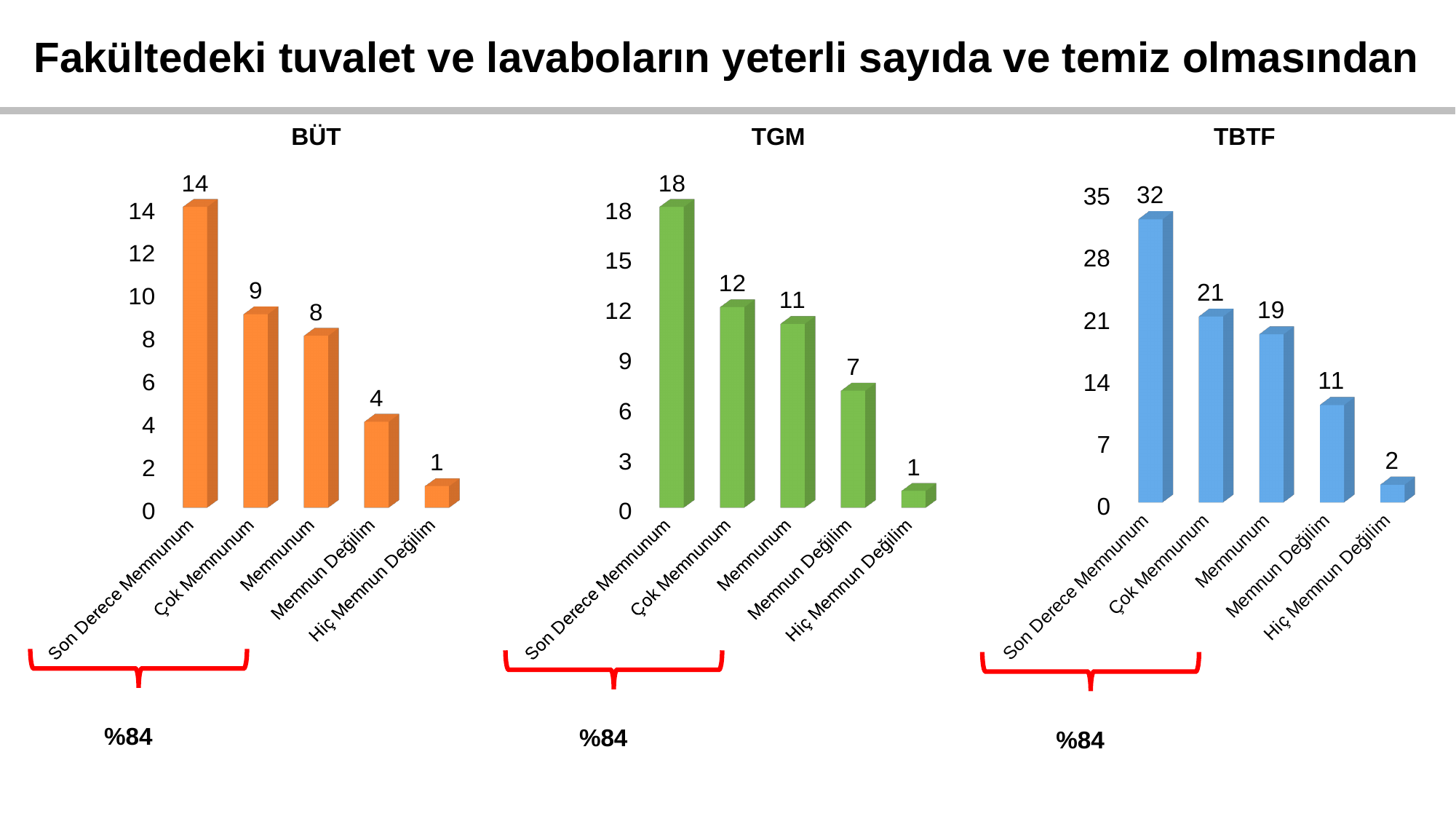
In the BÜT chart, what is the difference between Çok Memnunum and Memnunum? 1 What colour are the bars in the TBTF chart? blue What kind of chart is the TGM chart? bar chart In the TGM chart, which category has the lowest value? Hiç Memnun Değilim In the TBTF chart, what is the difference between Son Derece Memnunum and Memnunum? 13 In the TBTF chart, do the values rise or fall from left to right along the x axis? fall In the TGM chart, what is the value for Memnun Değilim? 7 In the TBTF chart, what is the value for Çok Memnunum? 21 In the BÜT chart, what is the value for Son Derece Memnunum? 14 How many categories does the BÜT chart show? 5 In the TGM chart, which is larger, Çok Memnunum or Memnunum? Çok Memnunum In the TBTF chart, which category has the highest value? Son Derece Memnunum